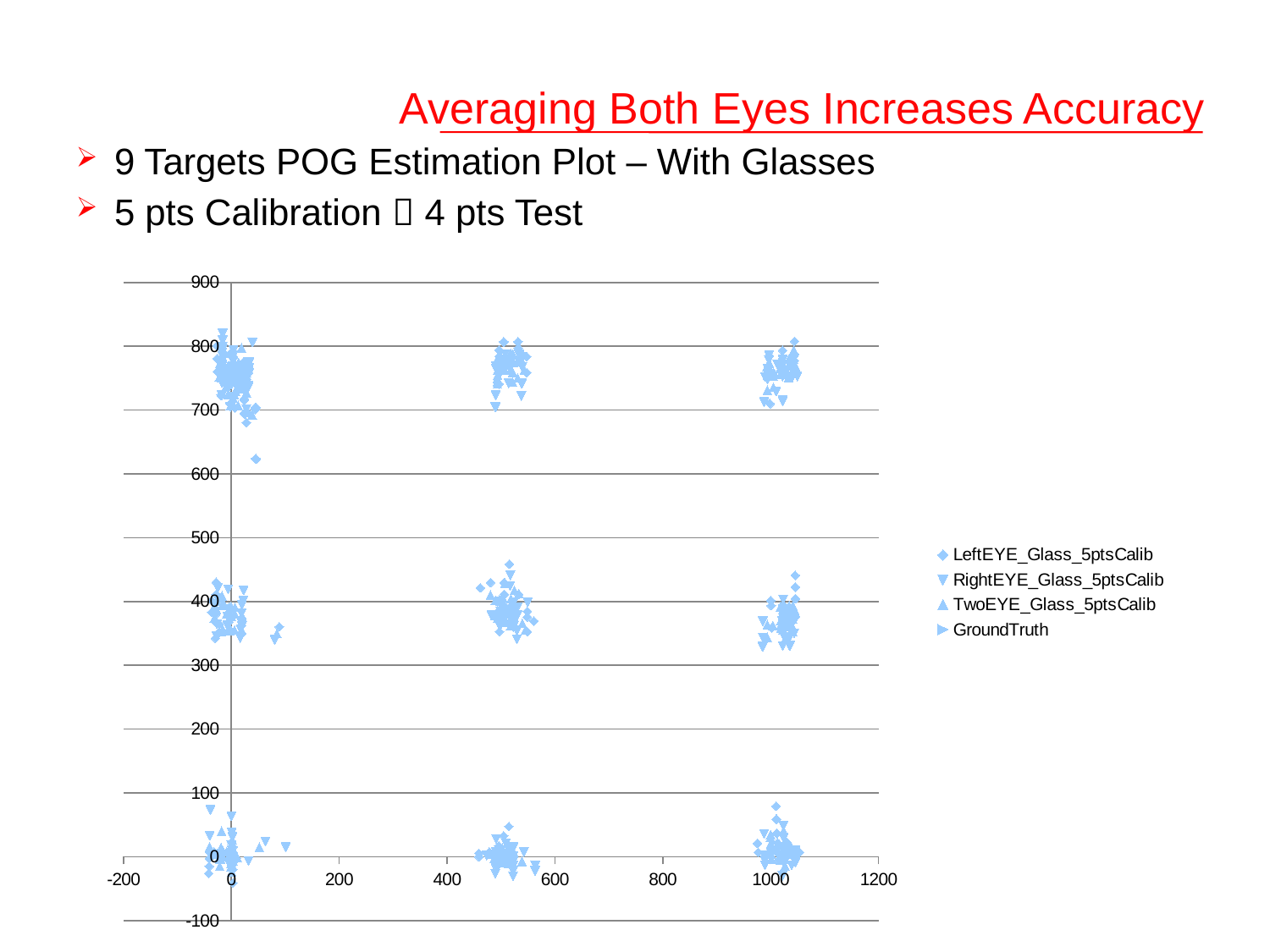
How many series does the legend list? 4 Are the x-values of the rightmost column of clusters greater or less than 800? greater Are the y-values of the middle-row cluster near x = 1000 greater or less than 500? less Are the y-values of the middle-row cluster near x = 0 greater or less than 300? greater What is the name of the last series listed in the legend? GroundTruth How many distinct clusters of points are plotted on the chart? 9 What kind of chart is shown on the slide? scatter plot What is the highest value shown on the y axis? 900 What is the name of the first series listed in the legend? LeftEYE_Glass_5ptsCalib